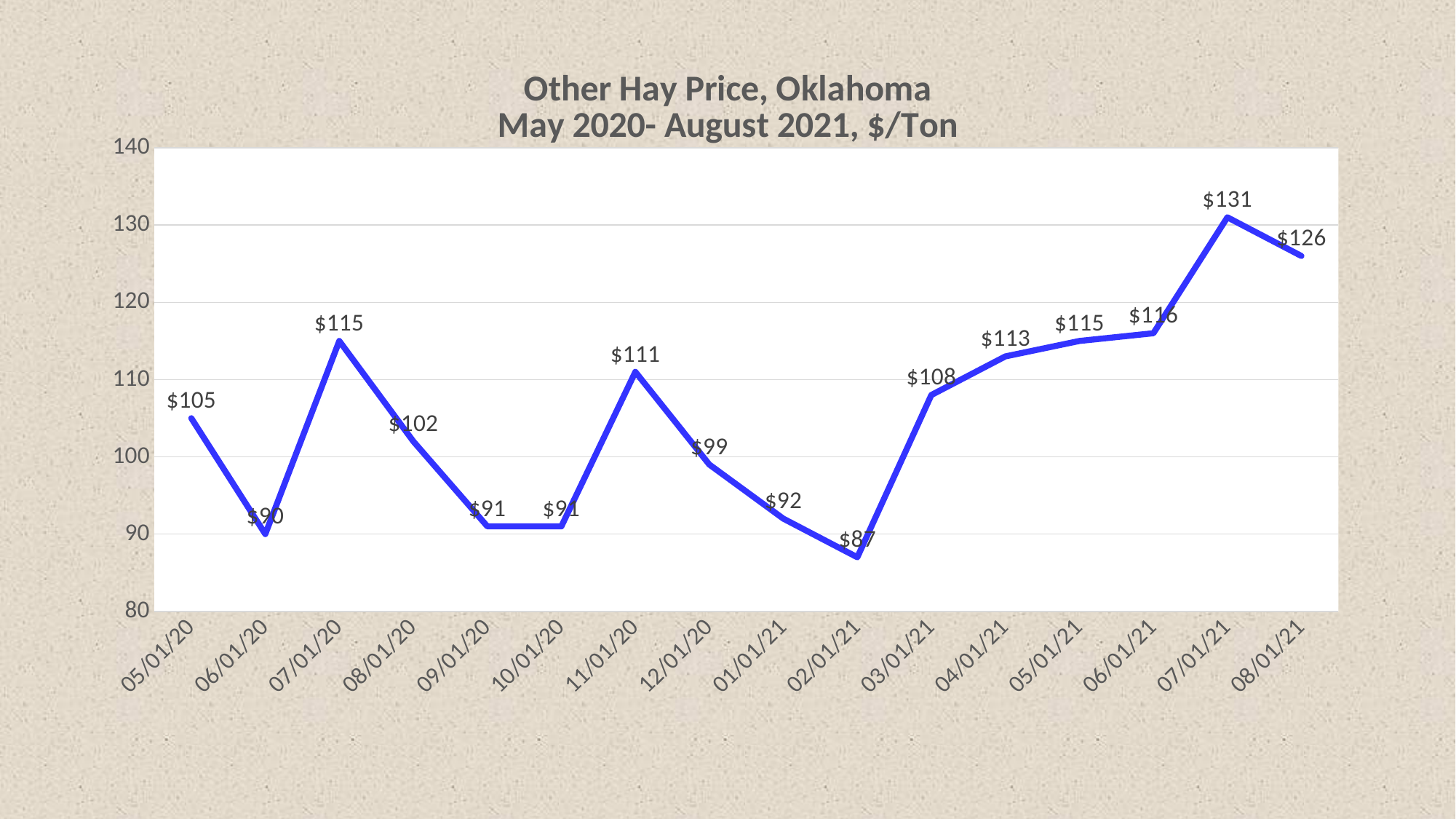
What is the title of the chart? Other Hay Price, Oklahoma May 2020- August 2021, $/Ton What is the difference between the price on 07/01/21 and the price on 08/01/21? $5 Which is larger, the price on 07/01/20 or the price on 11/01/20? 07/01/20 Do the prices rise or fall from 02/01/21 to 07/01/21? rise How many data points are plotted on the chart? 16 What is the Other Hay price for 05/01/20? $105 Is the price on 03/01/21 greater or less than 100? greater What kind of chart is shown on the slide? line chart Which date has the highest Other Hay price? 07/01/21 Which date has the lowest Other Hay price? 02/01/21 What is the Other Hay price for 02/01/21? $87 What is the Other Hay price for 07/01/21? $131